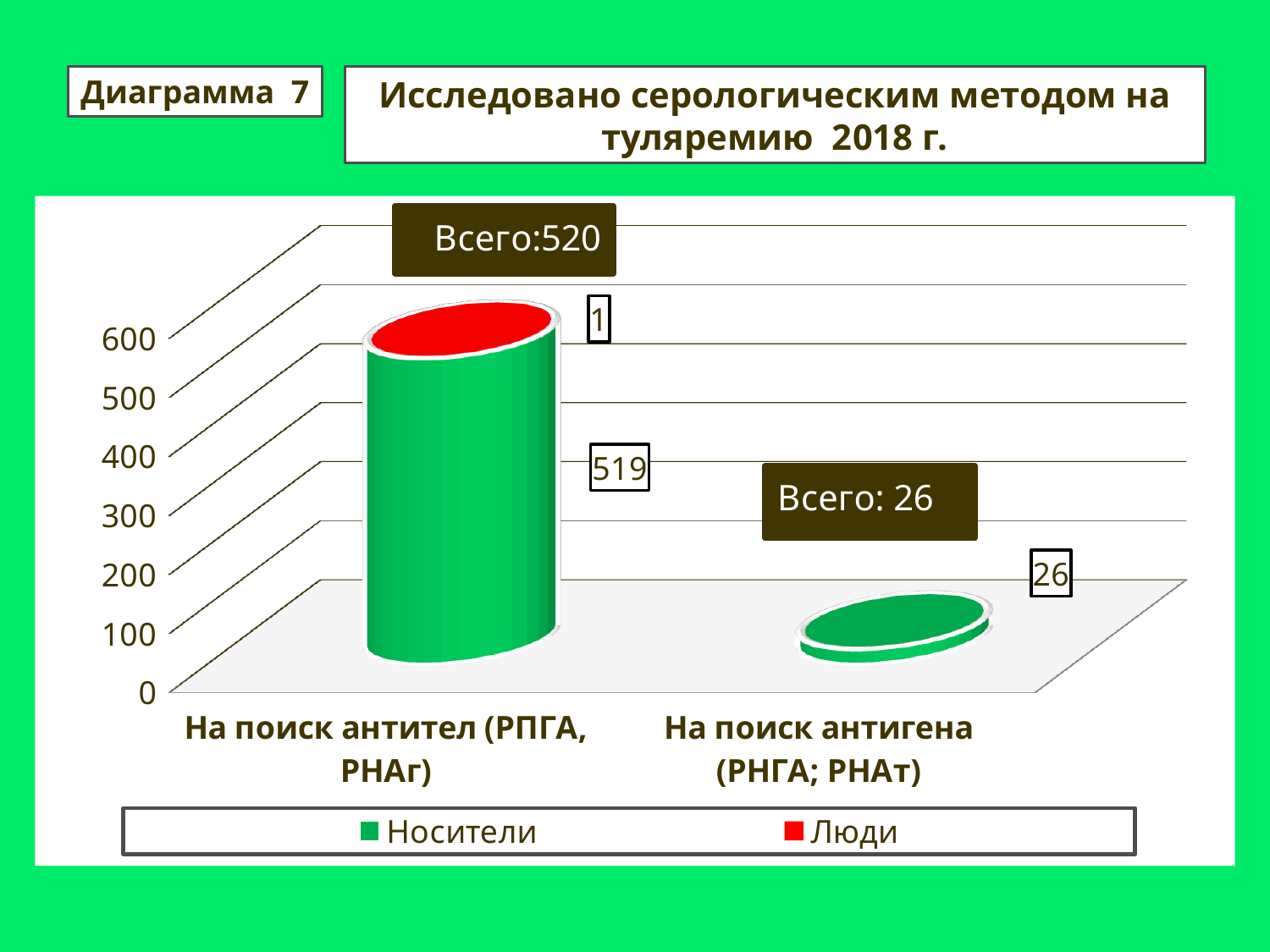
What is the total shown for the category На поиск антител (РПГА, РНАг)? 520 How many categories are shown on the x axis? 2 What is the difference between the Носители values for На поиск антител (РПГА, РНАг) and На поиск антигена (РНГА; РНАт)? 493 Which is larger: the Носители value for На поиск антител (РПГА, РНАг) or for На поиск антигена (РНГА; РНАт)? На поиск антител (РПГА, РНАг) What is the value for Люди in the category На поиск антител (РПГА, РНАг)? 1 What is the title of the chart? Исследовано серологическим методом на туляремию 2018 г. What is the value for Носители in the category На поиск антигена (РНГА; РНАт)? 26 What type of chart is shown on the slide? bar chart Which category has the higher total? На поиск антител (РПГА, РНАг) What is the value for Носители in the category На поиск антител (РПГА, РНАг)? 519 How many series does the legend list? 2 What is the total shown for the category На поиск антигена (РНГА; РНАт)? 26